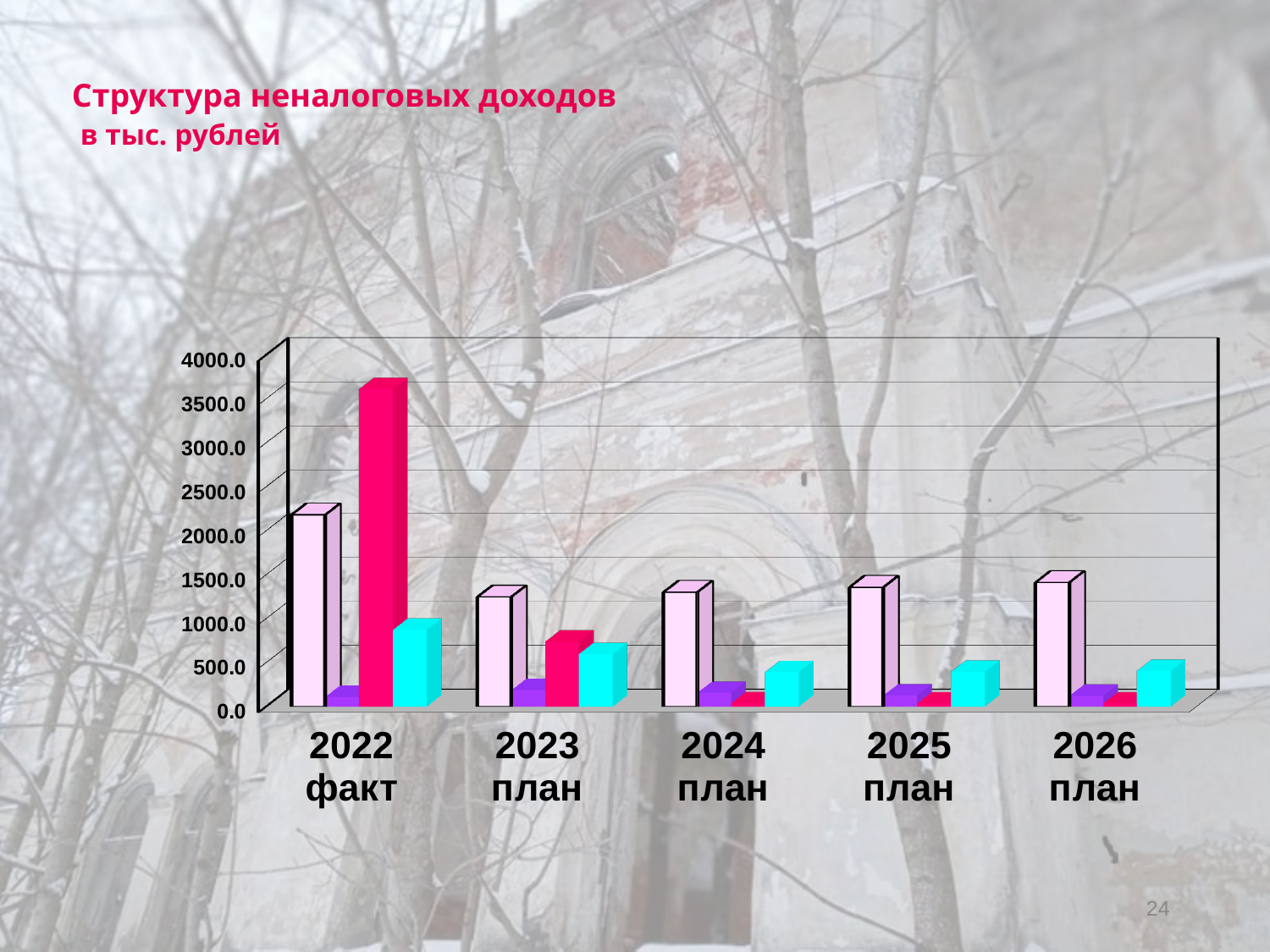
Is the value of the light pink bar for 2022 факт greater or less than 1500.0? greater Is the value of the tallest bar for 2022 факт greater or less than 3000.0? greater What kind of chart is shown on the slide? bar chart What is the title of the chart? Структура неналоговых доходов в тыс. рублей How many bars are plotted for each category? 4 Which category has the tallest bar in the chart? 2022 факт How many categories are shown along the x axis? 5 Is the value of the light pink bar for 2023 план greater or less than 1500.0? less For 2024 план, which is larger: the magenta bar or the cyan bar? the cyan bar Do the magenta bars rise or fall from 2022 факт to 2026 план? fall